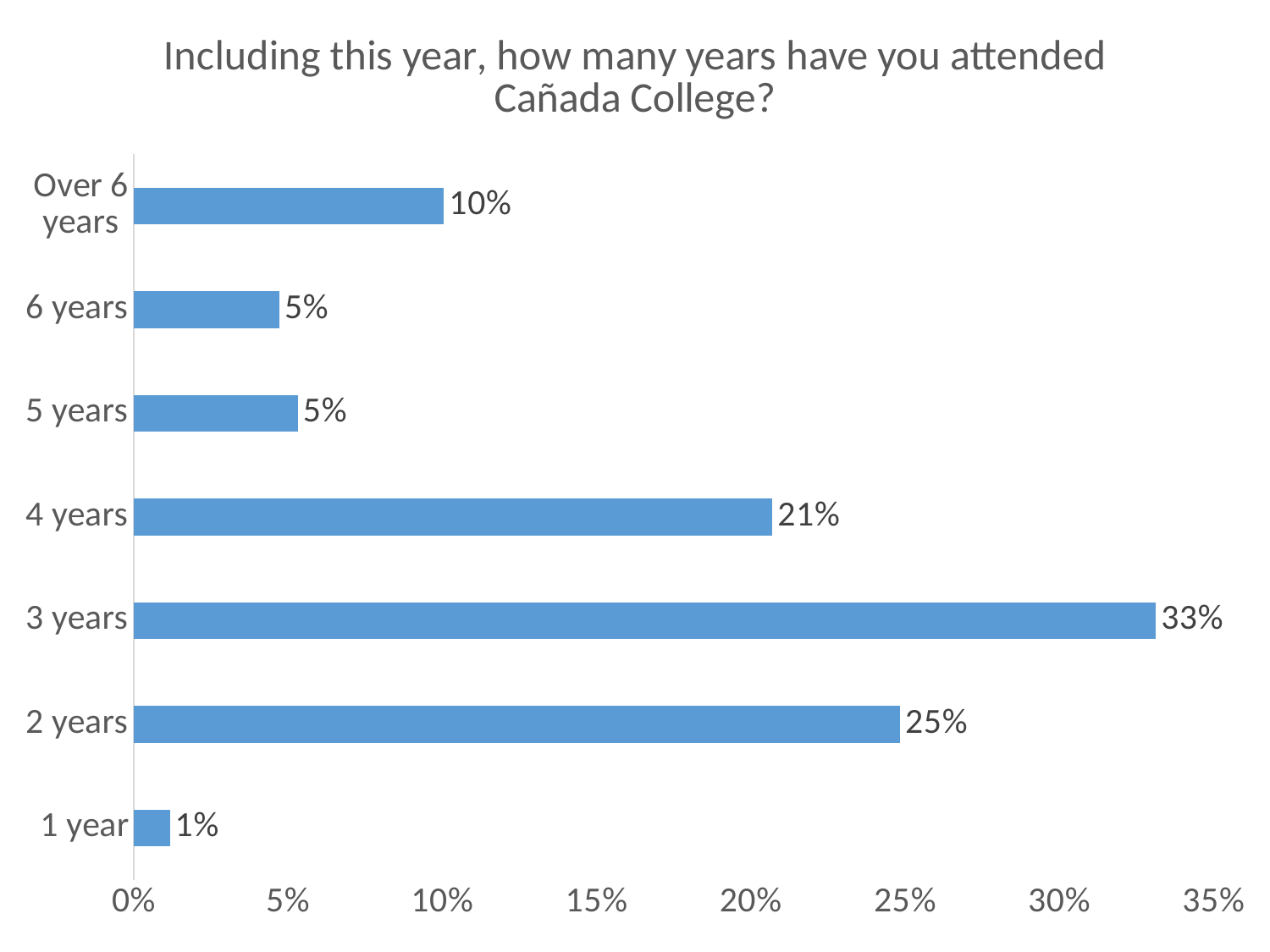
What percentage of respondents have attended Cañada College for 3 years? 33% What type of chart is shown on the slide? Bar chart What percentage of respondents have attended for 2 years? 25% What percentage of respondents have attended for 1 year? 1% What percentage of respondents have attended for over 6 years? 10% What is the title of the chart? Including this year, how many years have you attended Cañada College? Which category has the lowest percentage of respondents? 1 year Which is larger, the value for 4 years or the value for over 6 years? 4 years How many categories are shown in the chart? 7 What is the difference in percentage points between the 3 years and 2 years categories? 8 What is the difference in percentage points between the 4 years and over 6 years categories? 11 Which category has the highest percentage of respondents? 3 years